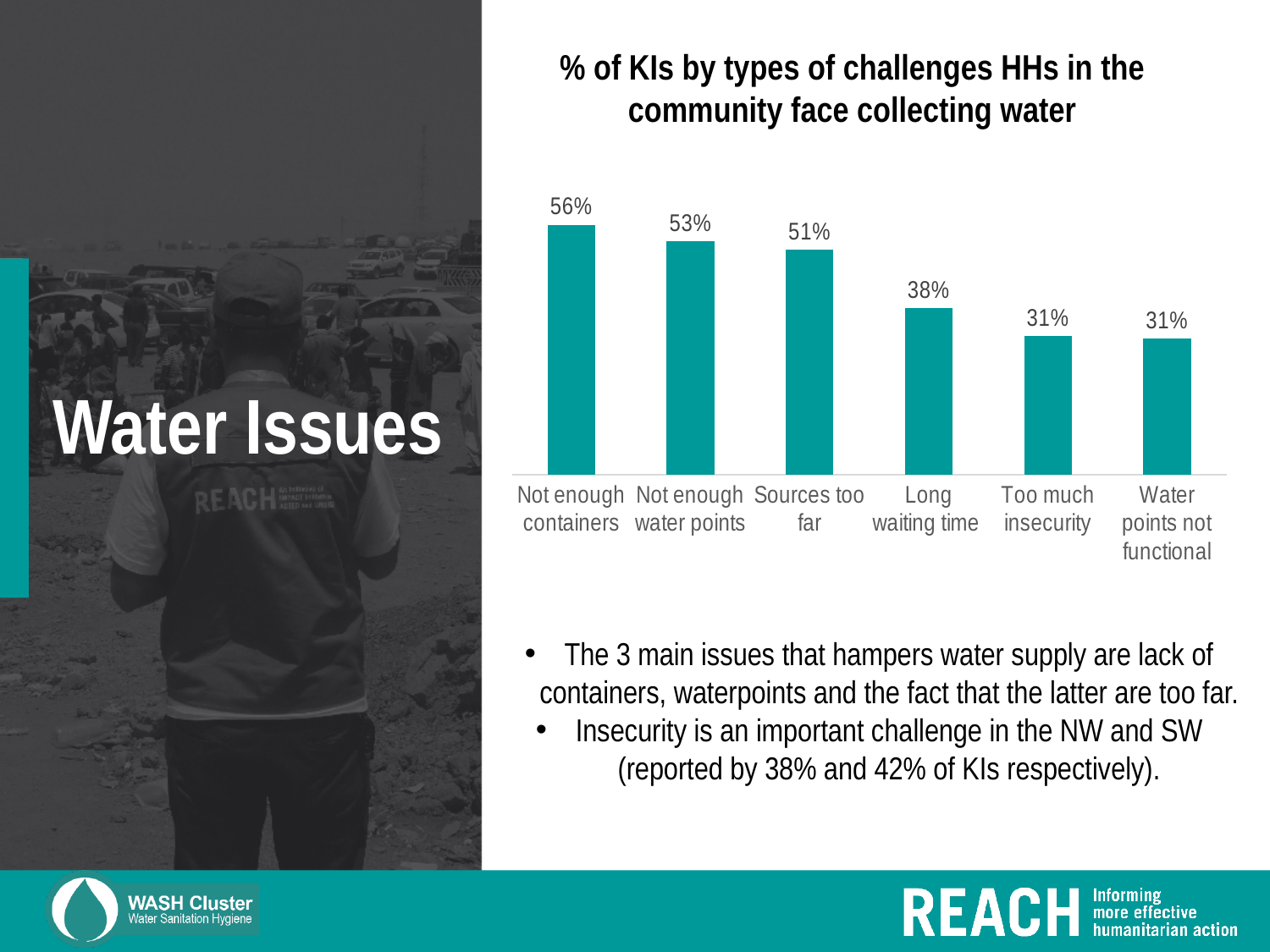
Which two categories share the same value of 31%? Too much insecurity and Water points not functional Which challenge has the highest percentage of KIs? Not enough containers What percentage of KIs reported 'Not enough containers' as a challenge? 56% Do the values rise or fall from left to right across the categories? Fall What is the difference between 'Not enough containers' and 'Not enough water points'? 3% Which is larger, 'Not enough water points' or 'Too much insecurity'? Not enough water points What percentage of KIs reported 'Sources too far'? 51% What kind of chart is shown on the slide? Bar chart What is the title of the chart? % of KIs by types of challenges HHs in the community face collecting water What is the difference between 'Sources too far' and 'Long waiting time'? 13% What is the value for 'Long waiting time'? 38% How many challenge categories are shown in the chart? 6